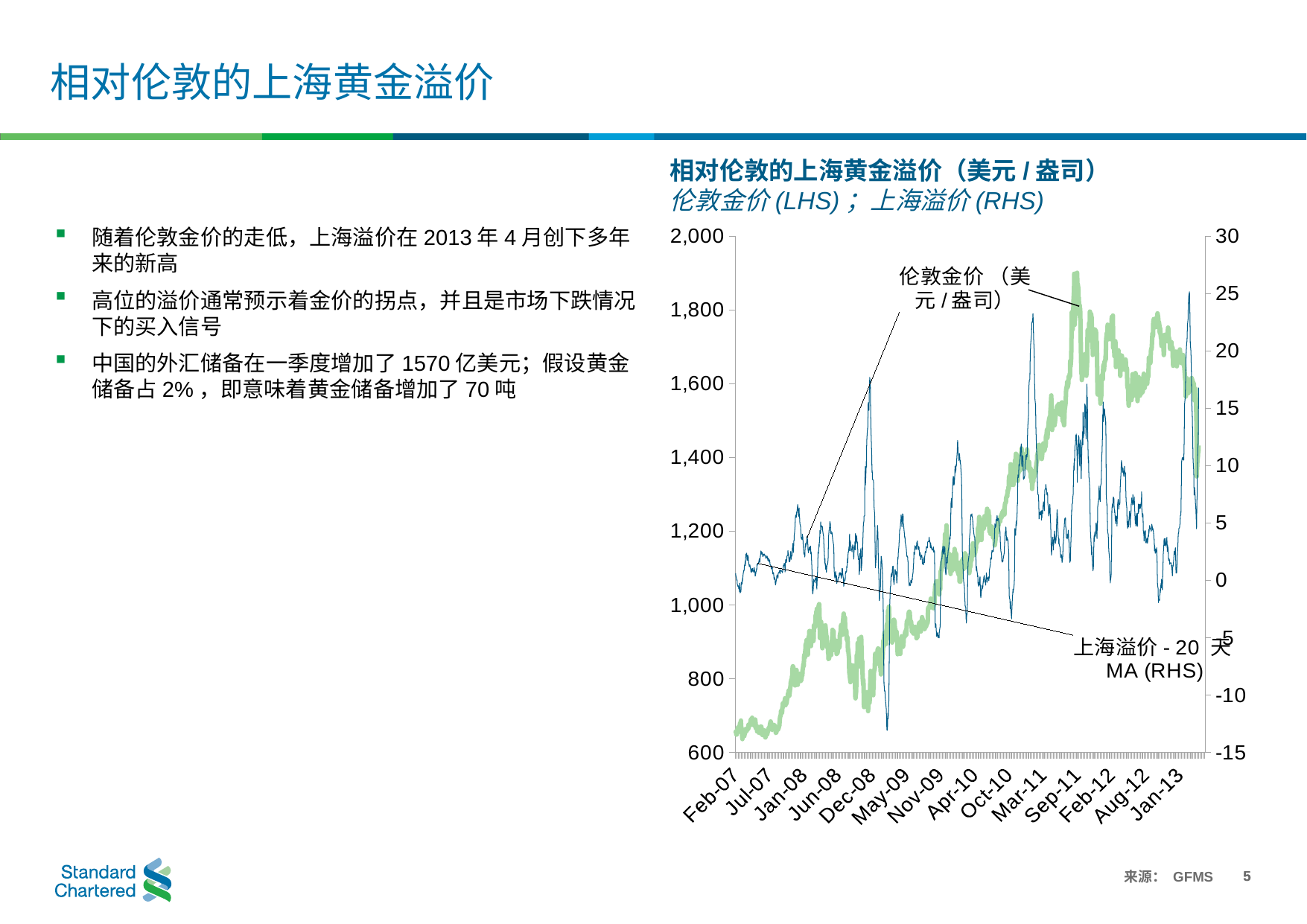
How many data series are plotted on the chart? 2 What is the maximum value shown on the left-hand axis? 2,000 Is the peak of the London gold price (伦敦金价) around Sep-11 greater or less than 1,800? greater Is the highest value of the Shanghai premium 20-day MA (上海溢价) near Jan-13 greater or less than 20? greater How many date labels are shown on the x axis? 14 What is the title of the chart? 相对伦敦的上海黄金溢价（美元 / 盎司） What kind of chart is shown on the slide? line chart Is the London gold price (伦敦金价) at Feb-07 greater or less than 800? less Which series is plotted on the right-hand axis (RHS)? 上海溢价 - 20 天 MA Does the London gold price (伦敦金价) rise or fall from Feb-07 to Sep-11? rise